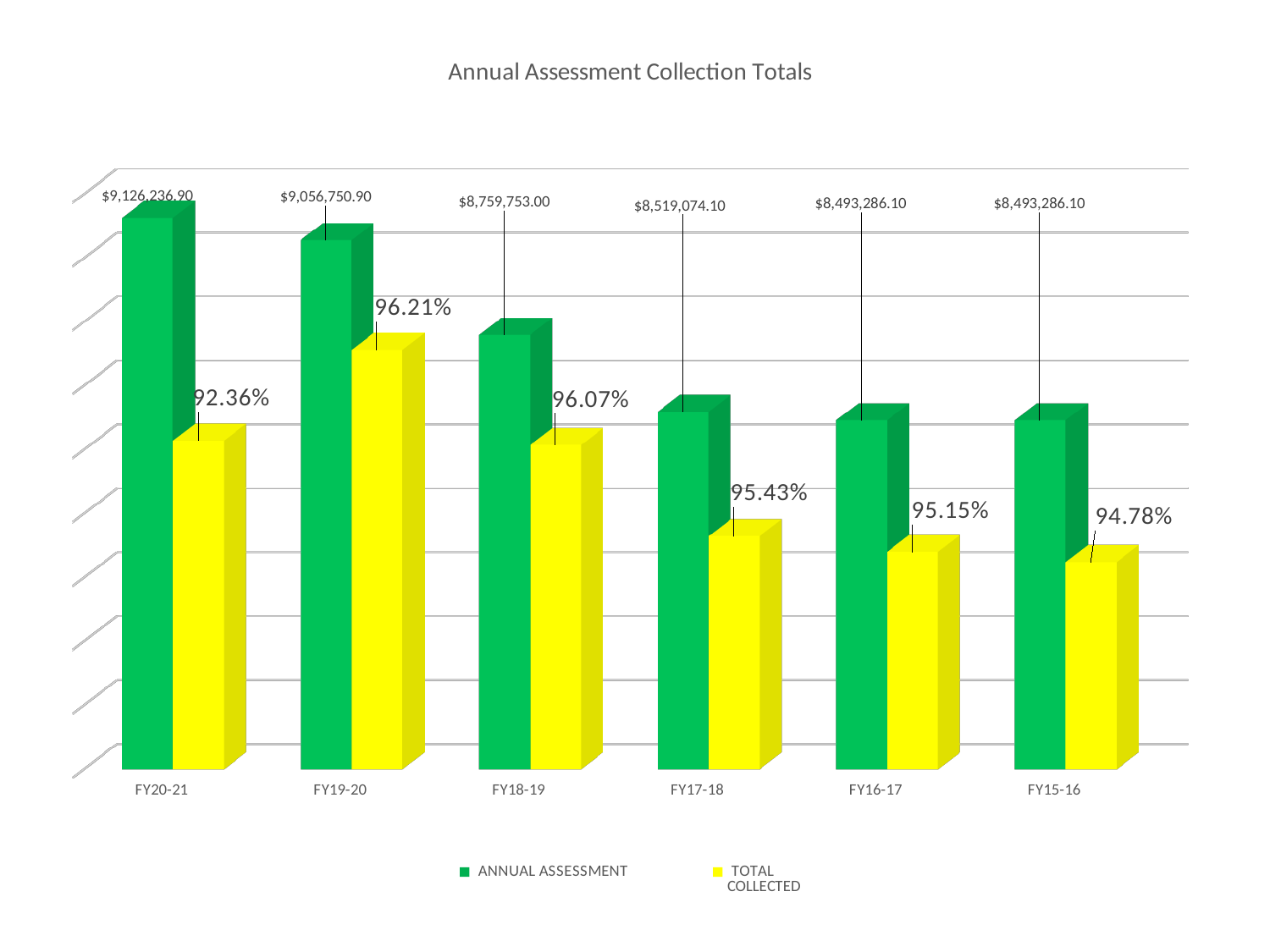
Which fiscal year has the lowest Total Collected percentage label? FY20-21 How many series does the legend list? 2 Which is larger, the Annual Assessment value for FY18-19 or for FY17-18? FY18-19 What is the Annual Assessment value for FY20-21? $9,126,236.90 What is the difference between the Annual Assessment values for FY20-21 and FY19-20? $69,486.00 What percentage label is shown on the Total Collected bar for FY18-19? 96.07% What is the title of the chart? Annual Assessment Collection Totals What type of chart is shown on the slide? Bar chart How many fiscal years are shown on the x axis? 6 Do the Annual Assessment bars rise or fall moving from FY20-21 to FY15-16 along the x axis? Fall Which fiscal year has the highest Annual Assessment value? FY20-21 What is the Annual Assessment value for FY17-18? $8,519,074.10